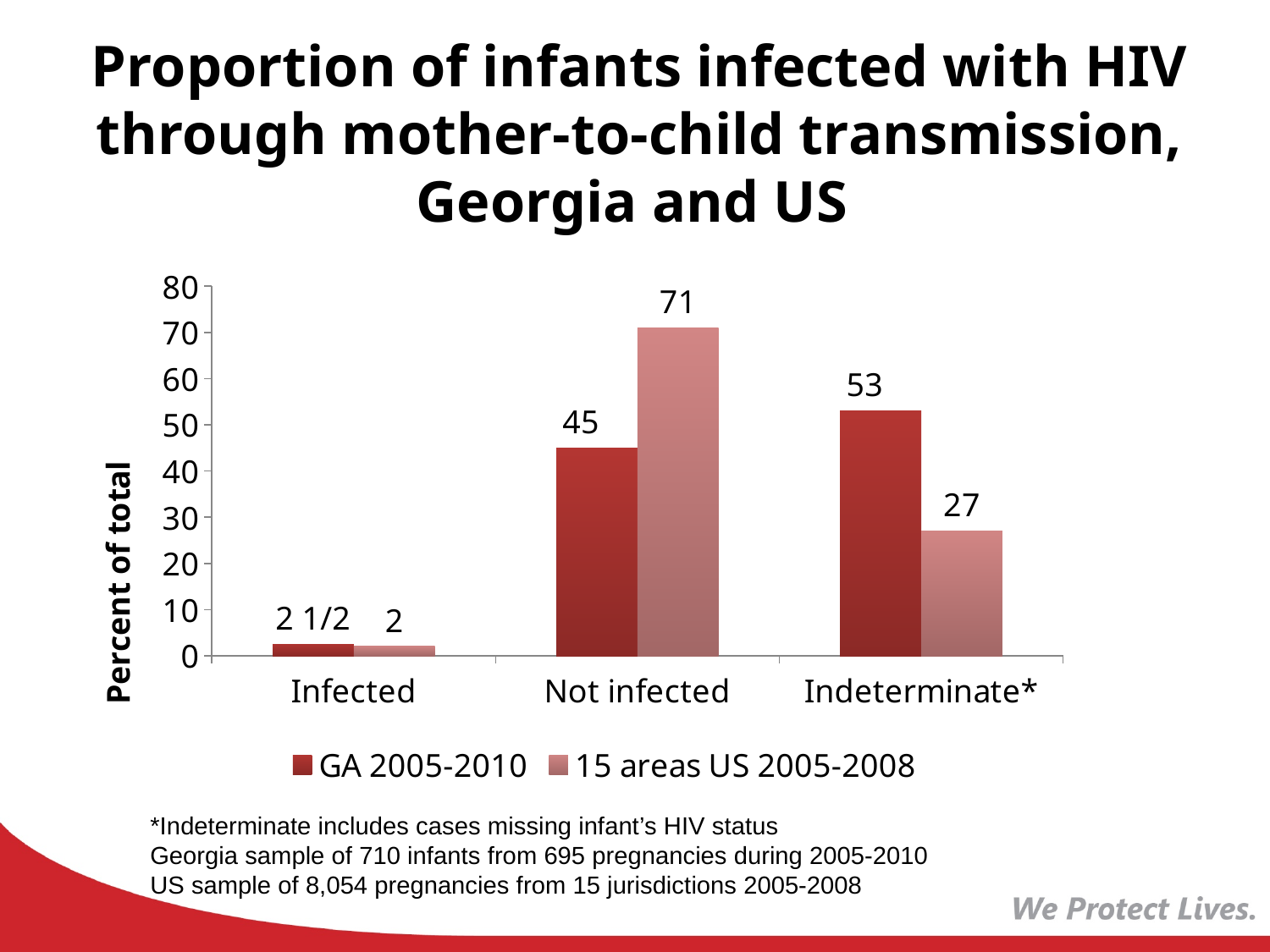
Which category has the lowest value for GA 2005-2010? Infected What is the value for 15 areas US 2005-2008 in the Infected category? 2 What is the value for GA 2005-2010 in the Not infected category? 45 What is the value for 15 areas US 2005-2008 in the Indeterminate* category? 27 What kind of chart is shown on the slide? Bar chart Which category has the highest value for 15 areas US 2005-2008? Not infected How many series does the legend list? 2 What is the value for GA 2005-2010 in the Indeterminate* category? 53 How many categories are shown on the x axis? 3 What is the difference between the 15 areas US 2005-2008 and GA 2005-2010 values in the Not infected category? 26 What is the value for 15 areas US 2005-2008 in the Not infected category? 71 In the Indeterminate* category, which series has the larger value, GA 2005-2010 or 15 areas US 2005-2008? GA 2005-2010